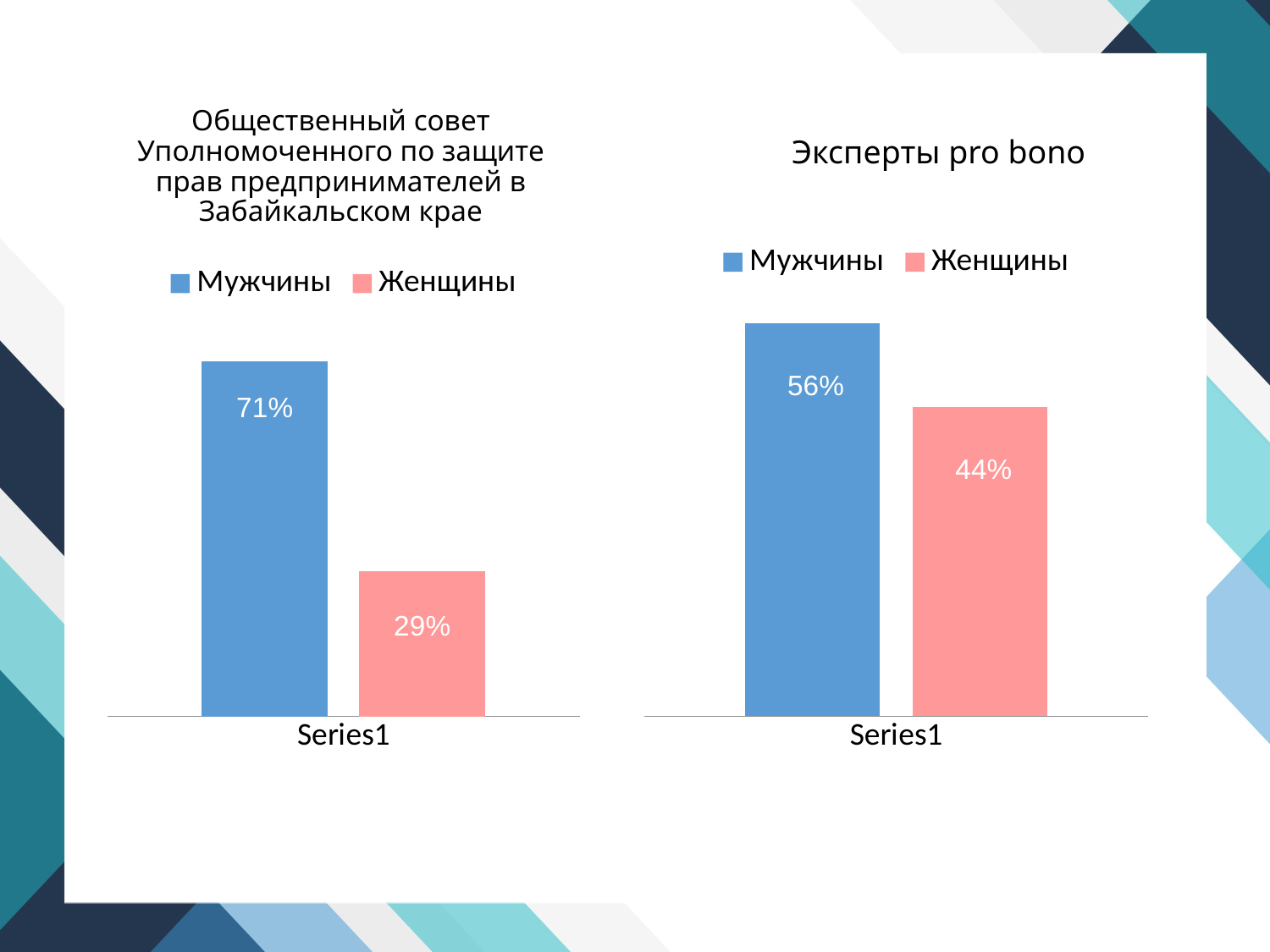
In the left chart (Общественный совет Уполномоченного...), which series has the higher value? Мужчины What kind of chart is the left chart (Общественный совет Уполномоченного...)? Bar chart In the right chart (Эксперты pro bono), what is the difference between the Мужчины and Женщины values? 12% In the right chart (Эксперты pro bono), which series has the lower value? Женщины In the right chart (Эксперты pro bono), what is the value for Женщины? 44% In the right chart (Эксперты pro bono), what is the value for Мужчины? 56% In the left chart (Общественный совет Уполномоченного...), what is the difference between the Мужчины and Женщины values? 42% In the left chart (Общественный совет Уполномоченного...), what is the value for Мужчины? 71% How many series does the legend of the right chart (Эксперты pro bono) list? 2 In the left chart (Общественный совет Уполномоченного...), what is the value for Женщины? 29% Is the Мужчины value larger in the left chart or in the right chart (Эксперты pro bono)? Left chart What is the title of the right chart? Эксперты pro bono